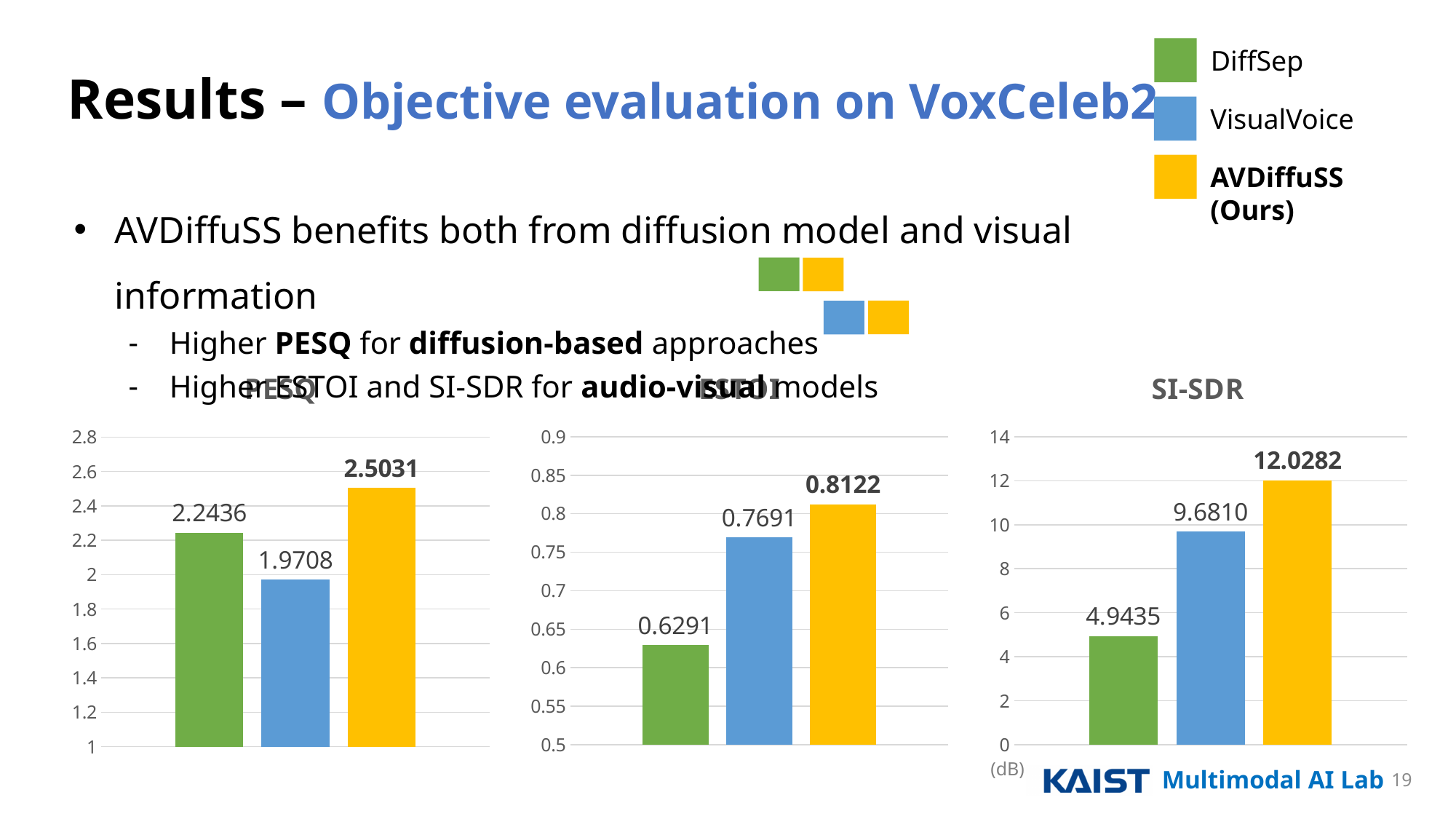
In the PESQ chart, which method has the lowest value? VisualVoice In the SI-SDR chart, what is the value for VisualVoice? 9.6810 In the PESQ chart, what is the difference between the AVDiffuSS (Ours) value and the DiffSep value? 0.2595 What kind of chart is the SI-SDR chart? Bar chart In the PESQ chart, what is the value for VisualVoice? 1.9708 In the ESTOI chart, what is the value for DiffSep? 0.6291 In the ESTOI chart, which method has the lowest value? DiffSep How many series does the legend list? 3 In the SI-SDR chart, which method has the highest value? AVDiffuSS (Ours) In the PESQ chart, what is the value for AVDiffuSS (Ours)? 2.5031 In the SI-SDR chart, what is the difference between the VisualVoice value and the DiffSep value? 4.7375 In the PESQ chart, which is larger: the value for DiffSep or the value for VisualVoice? DiffSep